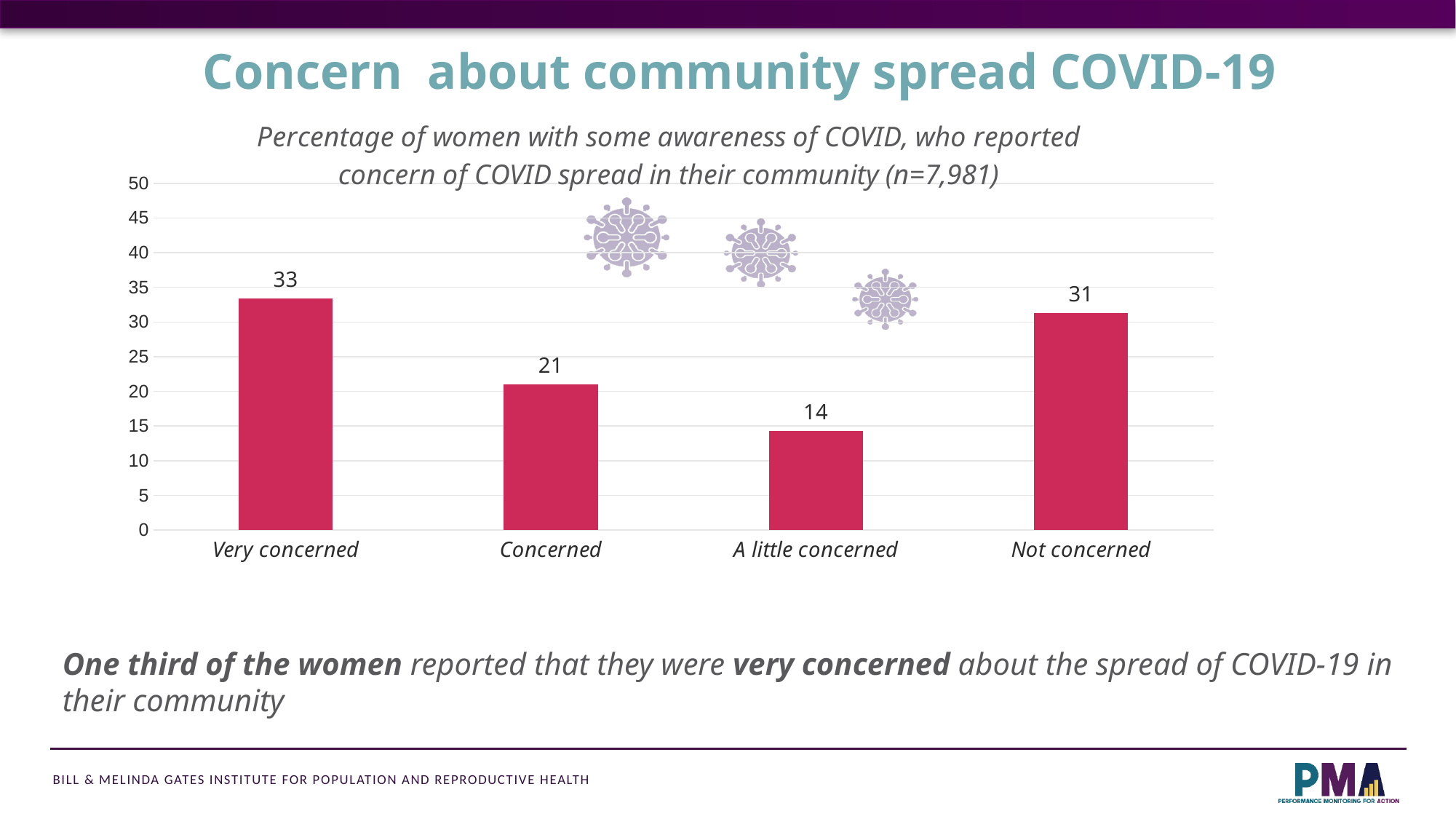
What is the value for Not concerned? 31 What is the difference between the values for Very concerned and Not concerned? 2 What is the value for Very concerned? 33 How many categories are shown on the x axis? 4 What is the value for A little concerned? 14 Which category has the lowest value? A little concerned What is the value for Concerned? 21 Which category has the highest value? Very concerned Which is larger, the value for Concerned or the value for Not concerned? Not concerned What is the sample size (n) stated in the chart subtitle? 7,981 What kind of chart is shown on the slide? Bar chart What is the difference between the values for Concerned and A little concerned? 7